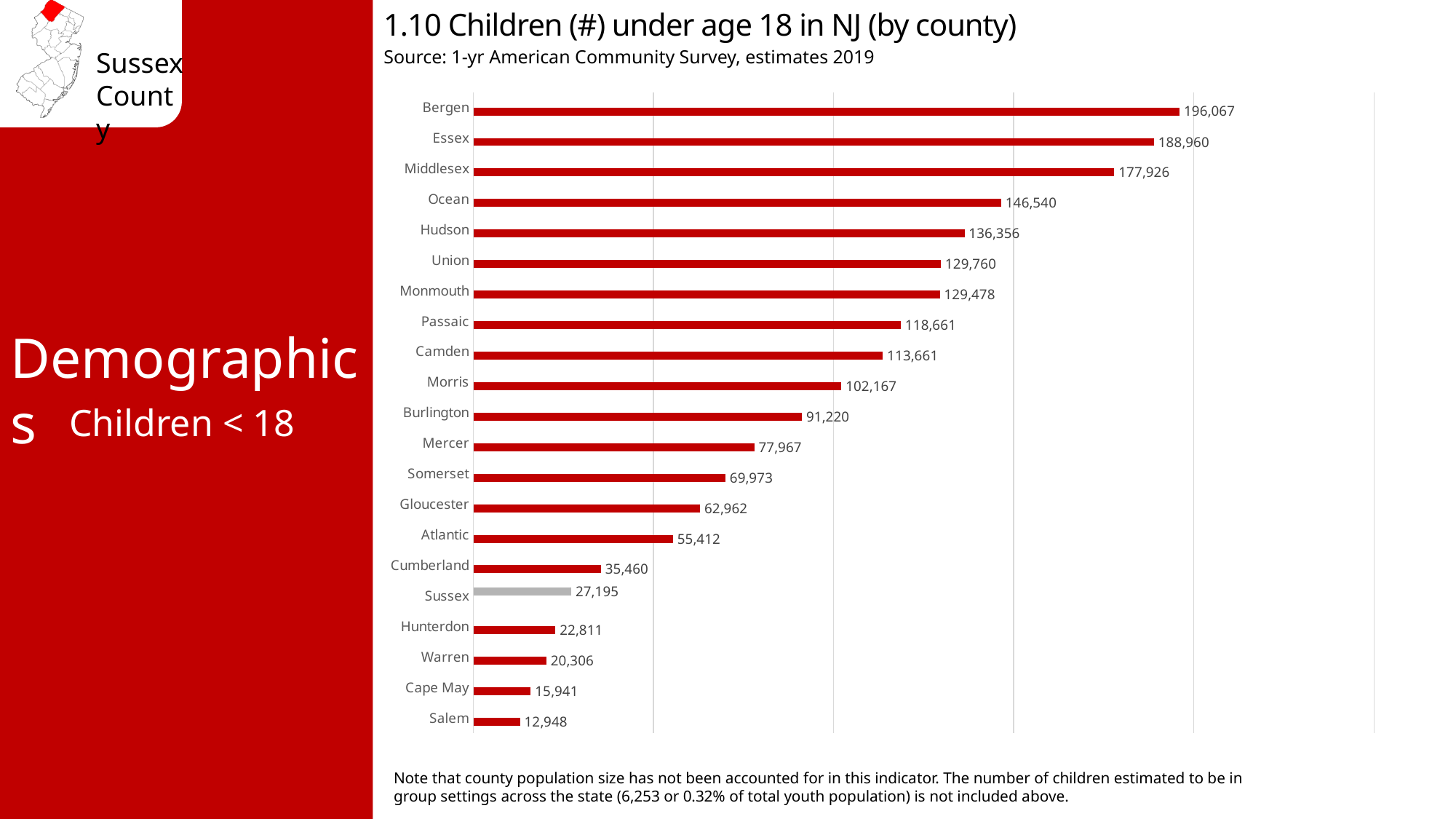
What is the value shown for Salem County? 12,948 Which has a larger value, Morris or Burlington? Morris What type of chart is shown on the slide? bar chart What is the difference between the values for Cumberland and Sussex? 8,265 What is the value shown for Morris County? 102,167 How many children under age 18 are in Bergen County? 196,067 What is the value shown for Sussex County? 27,195 Which county has the lowest number of children under age 18? Salem Which county's bar is shown in a different colour (grey) from the others? Sussex What is the difference between the values for Bergen and Essex? 7,107 How many counties are shown in the chart? 21 Which county has the highest number of children under age 18? Bergen